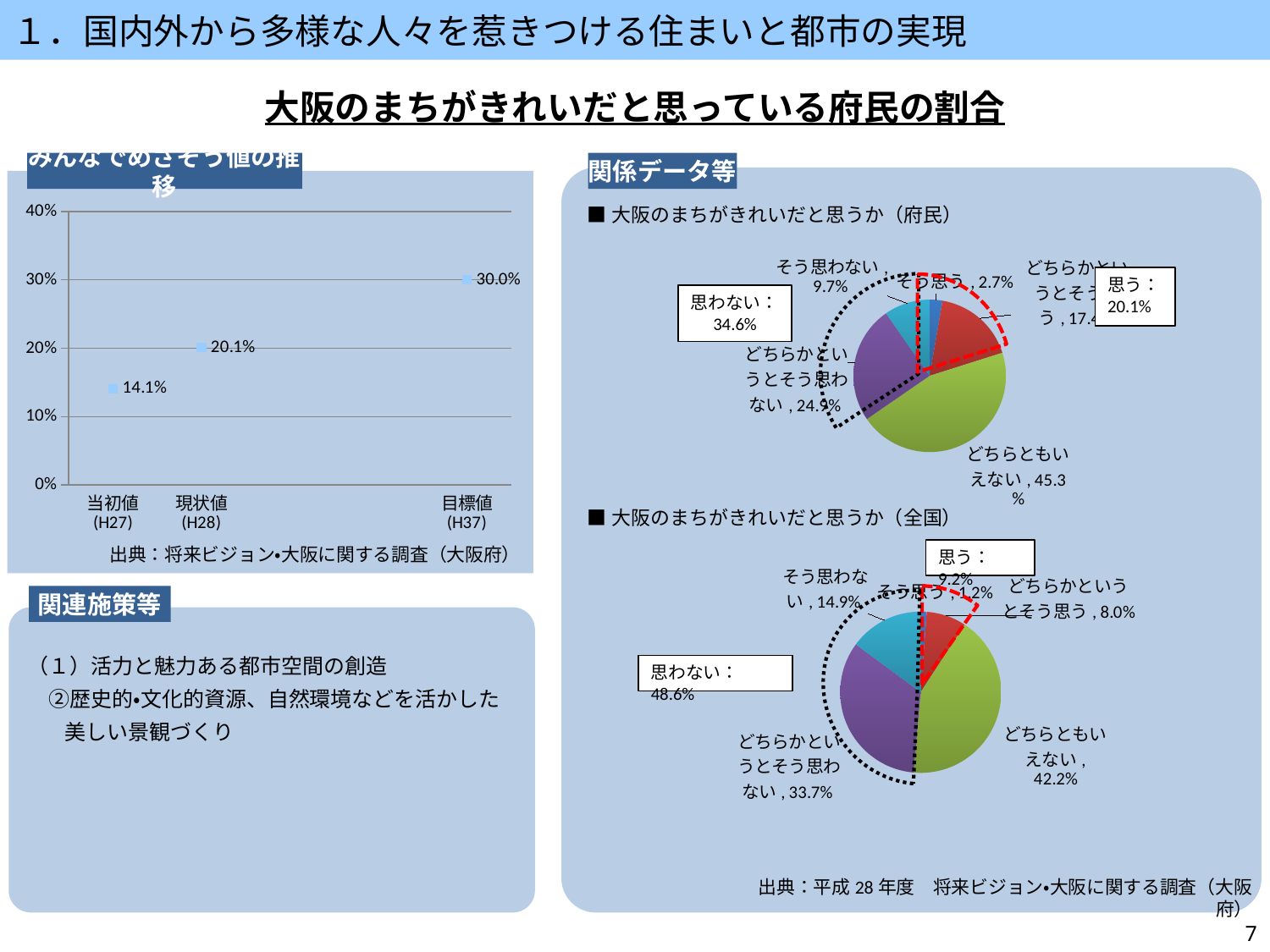
Which is larger: the share for そう思わない in the upper pie chart (府民) or in the lower pie chart (全国)? 全国 (14.9%) In the upper pie chart (大阪のまちがきれいだと思うか 府民), which category has the smallest share? そう思う In the lower pie chart (大阪のまちがきれいだと思うか 全国), what is the share for どちらかというとそう思わない? 33.7% What kind of chart is used for the 関係データ等 section on the right? pie chart In the left chart 'みんなでめざそう値の推移', do the values rise or fall from 当初値 (H27) to 目標値 (H37)? rise In the left chart 'みんなでめざそう値の推移', what is the value for 目標値 (H37)? 30.0% In the left chart 'みんなでめざそう値の推移', what is the value for 現状値 (H28)? 20.1% In the upper pie chart (大阪のまちがきれいだと思うか 府民), what is the combined share labelled 思わない? 34.6% In the lower pie chart (大阪のまちがきれいだと思うか 全国), which category has the largest share? どちらともいえない In the upper pie chart (大阪のまちがきれいだと思うか 府民), what is the share for どちらともいえない? 45.3% In the left chart 'みんなでめざそう値の推移', how many data points are plotted? 3 In the left chart 'みんなでめざそう値の推移', what is the difference between the 目標値 (H37) and the 当初値 (H27)? 15.9%